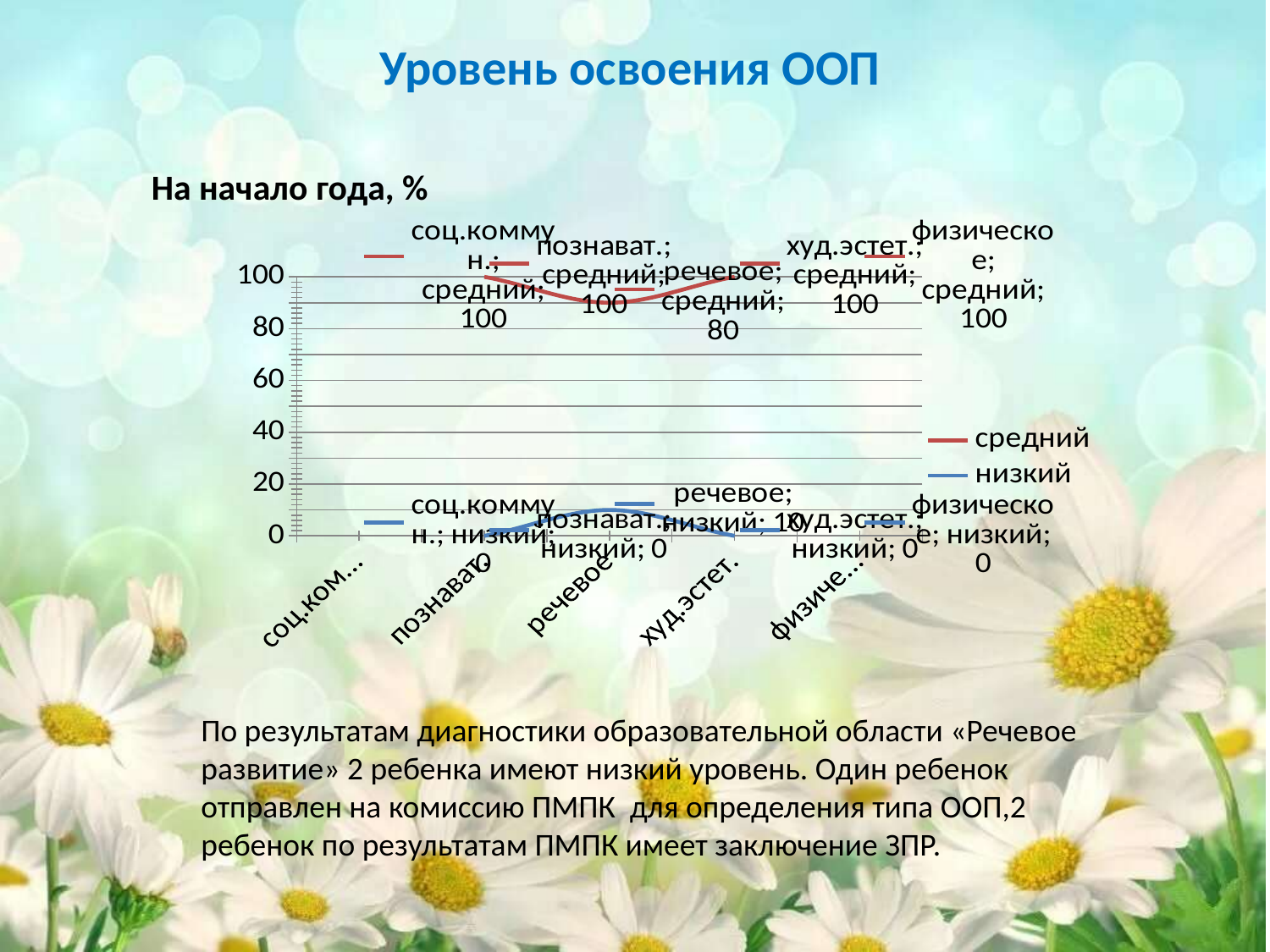
Which category has the lowest value in the средний series? речевое How many categories are plotted along the x axis of the chart? 5 How many series does the chart legend list? 2 What is the title of the chart? На начало года, % Is the низкий value for речевое greater or less than 20? less What kind of chart is shown on the slide? line chart What is the value of the средний series for речевое? 80 What is the value of the низкий series for худ.эстет.? 0 What is the value of the низкий series for физическое? 0 What is the value of the средний series for познават.? 100 What is the difference between the средний values for познават. and речевое? 20 Which category has the highest value in the низкий series? речевое